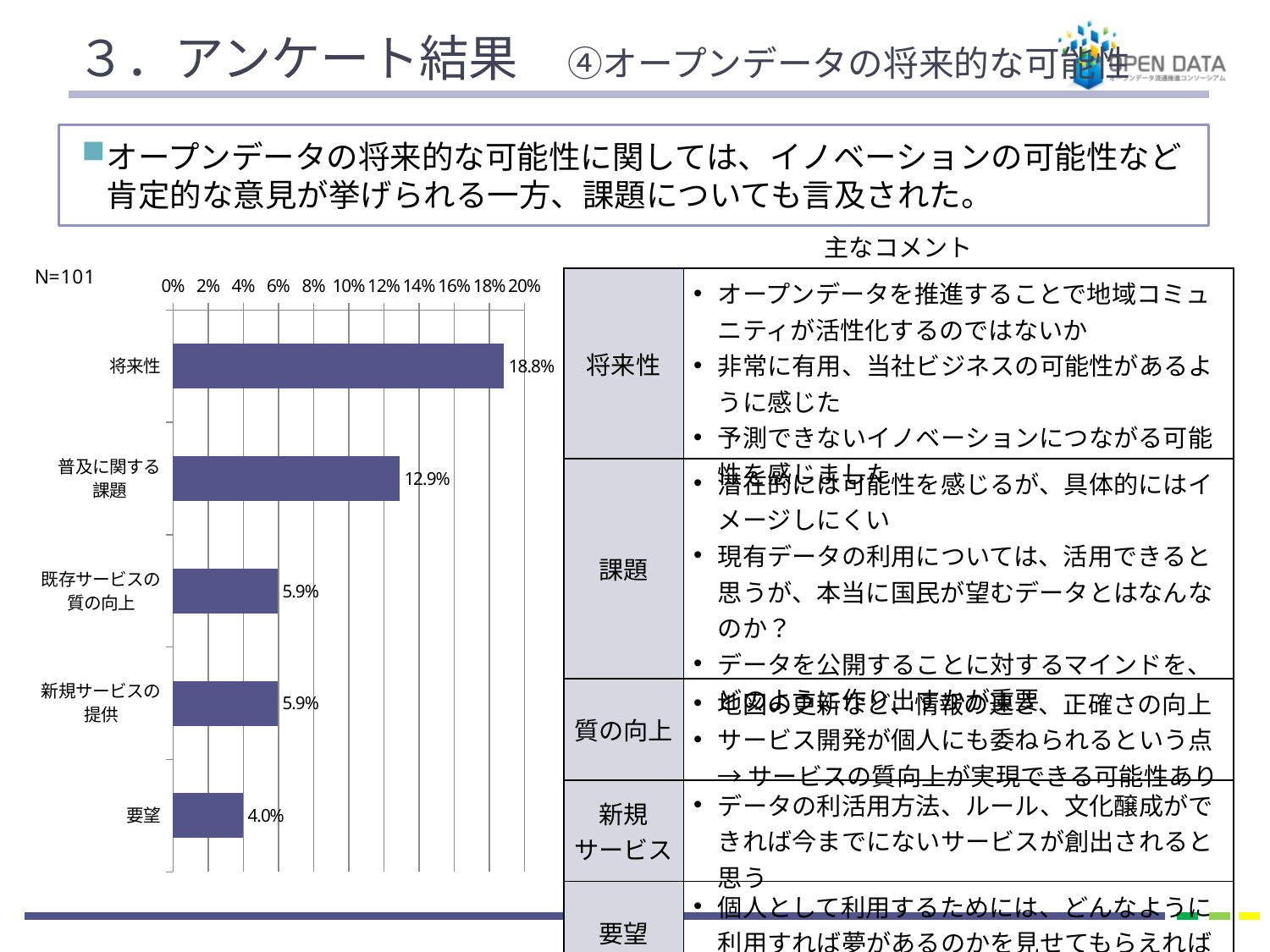
What is the value for 将来性? 18.8% What is the value for 既存サービスの質の向上? 5.9% What is the value for 要望? 4.0% Which category has the highest value? 将来性 Is the value for 将来性 greater or less than 16%? greater Which is larger, the value for 普及に関する課題 or the value for 要望? 普及に関する課題 What is the difference between the values for 将来性 and 普及に関する課題? 5.9% What is the value for 普及に関する課題? 12.9% What kind of chart is shown on the slide? bar chart Which category has the lowest value? 要望 What is the sample size (N) shown next to the chart? N=101 How many categories are shown in the chart? 5